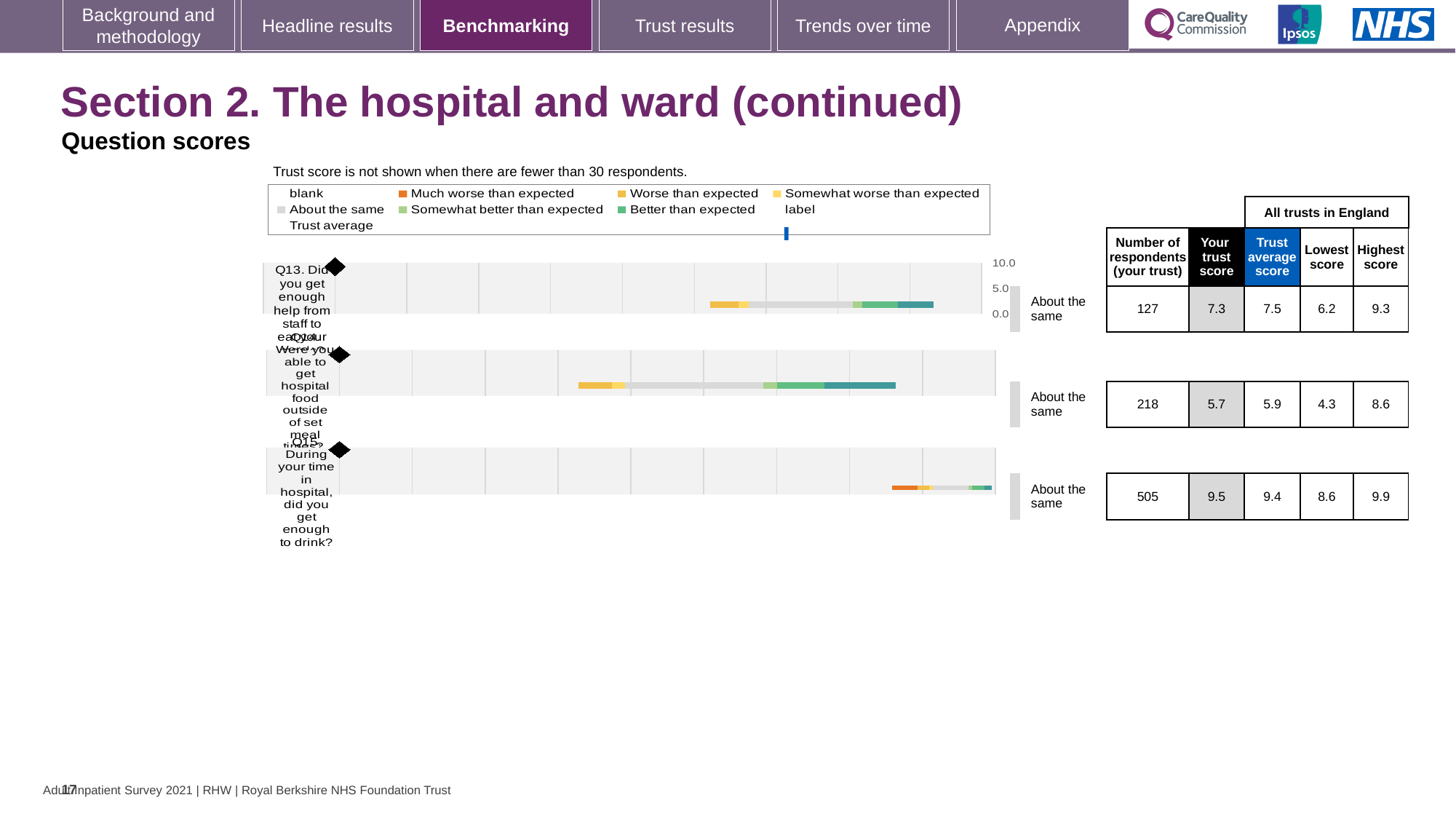
What is the trust average score for Q15 (During your time in hospital, did you get enough to drink?)? 9.4 Which question has the lowest 'Your trust score'? Q14 What type of chart is used to show the question scores? Bar chart What is the 'Your trust score' for Q13 (Did you get enough help from staff to eat your meals?)? 7.3 How many questions are shown in the chart? 3 What is the difference between your trust score and the trust average score for Q15? 0.1 For Q13, which is larger: your trust score or the trust average score? Trust average score What is the lowest score across all trusts in England for Q13? 6.2 Which question has the highest 'Your trust score'? Q15 What is the highest score across all trusts in England for Q15? 9.9 How many respondents from your trust answered Q14 (Were you able to get hospital food outside of set meal times?)? 218 What is the difference between the highest score and the lowest score for Q14? 4.3